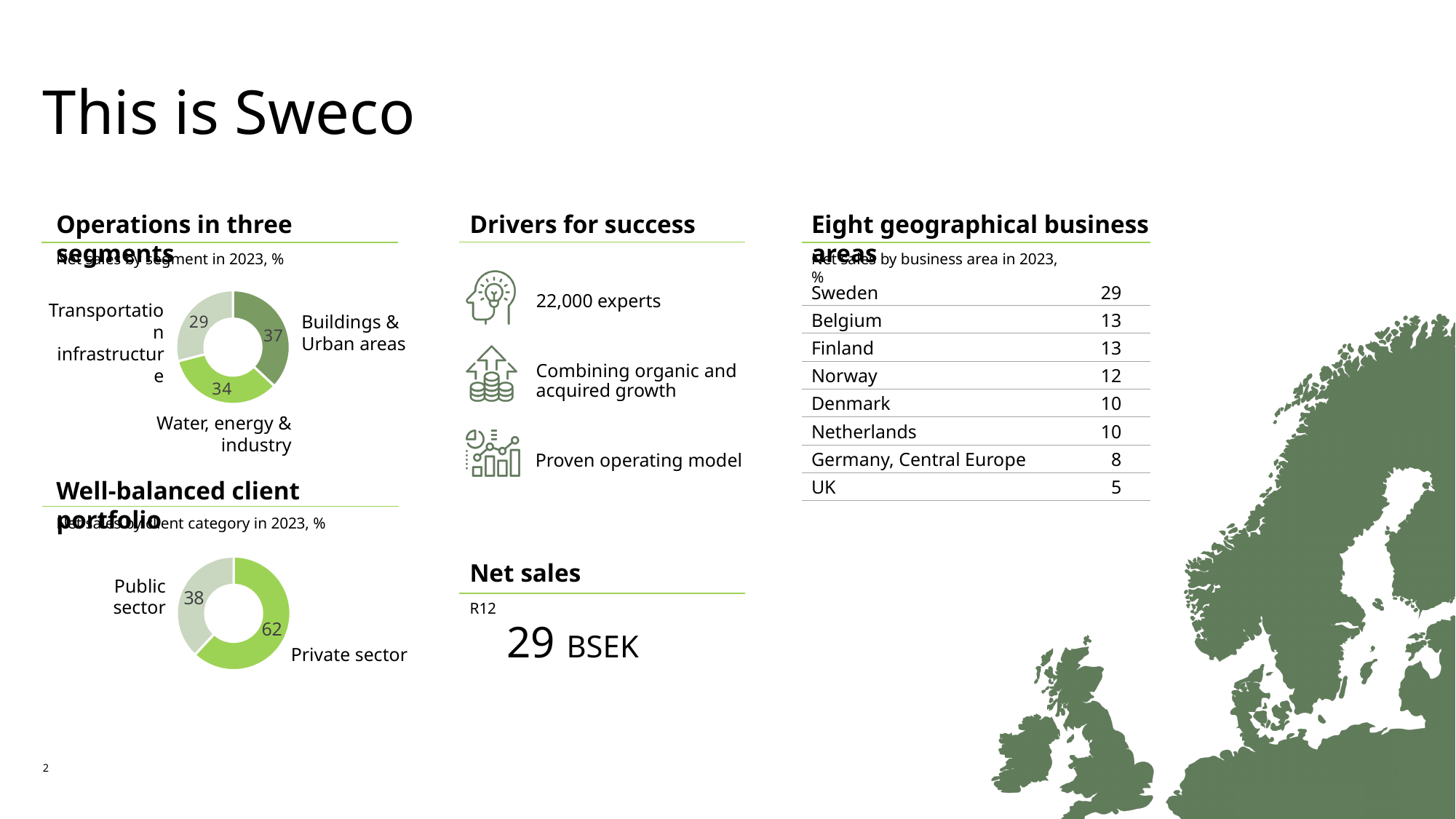
In the 'Net sales by segment in 2023, %' chart, what is the difference between Buildings & Urban areas and Water, energy & industry? 3 In the 'Net sales by segment in 2023, %' chart, how many segments are shown? 3 In the 'Net sales by segment in 2023, %' chart, what is the value for Buildings & Urban areas? 37 In the 'Net sales by segment in 2023, %' chart, which segment has the largest share? Buildings & Urban areas In the 'Net sales by client category in 2023, %' chart, what is the difference between Private sector and Public sector? 24 In the 'Net sales by client category in 2023, %' chart, which is larger, Public sector or Private sector? Private sector In the 'Net sales by segment in 2023, %' chart, what is the value for Transportation infrastructure? 29 In the 'Net sales by client category in 2023, %' chart, what is the value for Public sector? 38 What type of chart is used for 'Net sales by segment in 2023, %'? Donut chart In the 'Net sales by client category in 2023, %' chart, how many client categories are shown? 2 In the 'Net sales by client category in 2023, %' chart, what is the value for Private sector? 62 In the 'Net sales by segment in 2023, %' chart, which segment has the smallest share? Transportation infrastructure